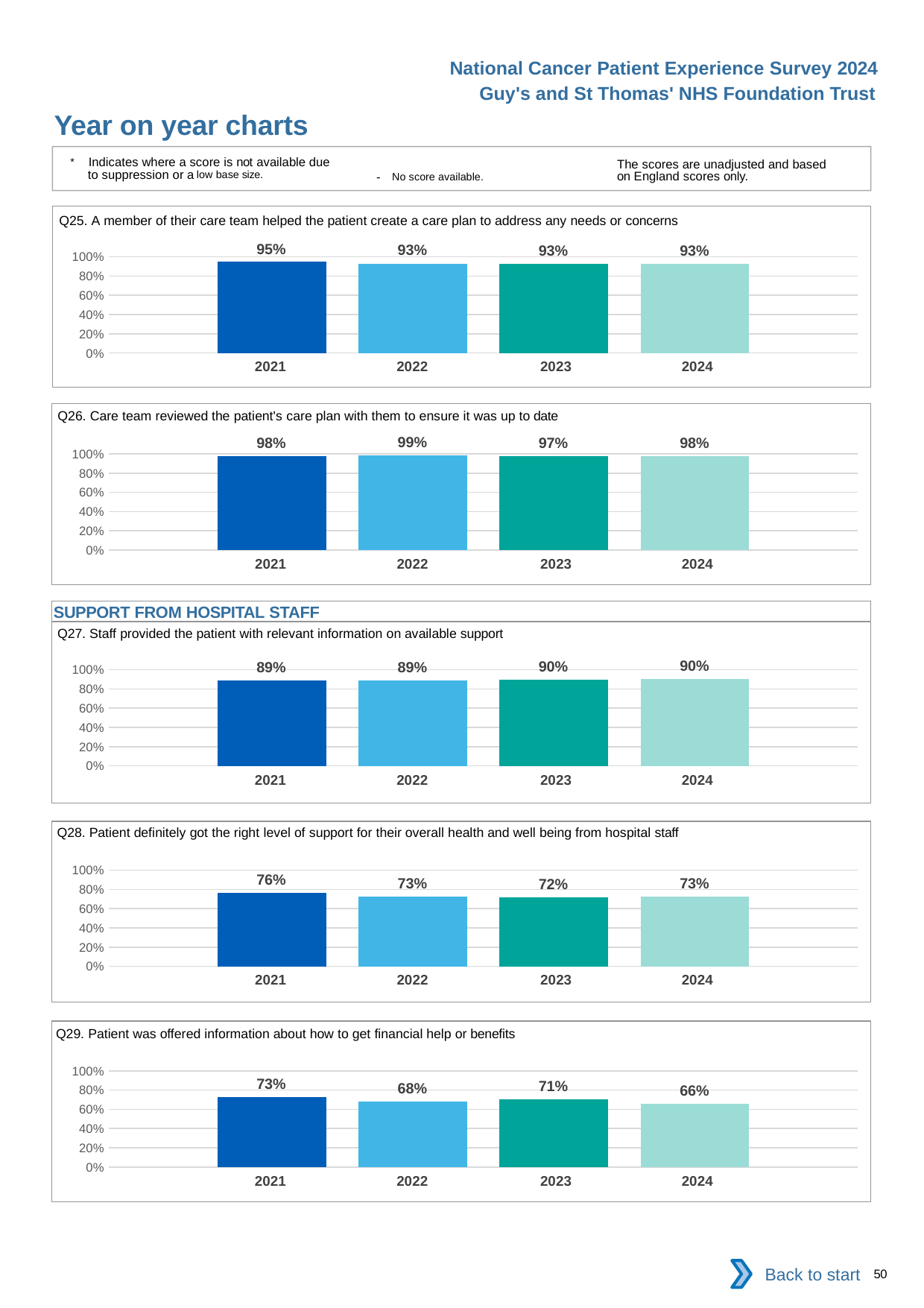
In the Q29 chart, which year has the lowest value? 2024 What kind of chart is the Q27 chart? bar chart How many years are shown in the Q25 chart? 4 In the Q28 chart, what is the difference between the 2021 value and the 2023 value? 4% In the Q28 chart, which year has the highest value? 2021 In the Q26 chart, which year has the highest value? 2022 In the Q29 chart, what is the difference between the 2021 value and the 2024 value? 7% In the Q27 chart, what is the value for 2024? 90% In the Q25 chart, what is the value for 2021? 95% In the Q28 chart, is the value for 2021 greater or less than 80%? less In the Q26 chart, which year has the lowest value? 2023 In the Q29 chart, which is larger, the value for 2022 or the value for 2023? 2023